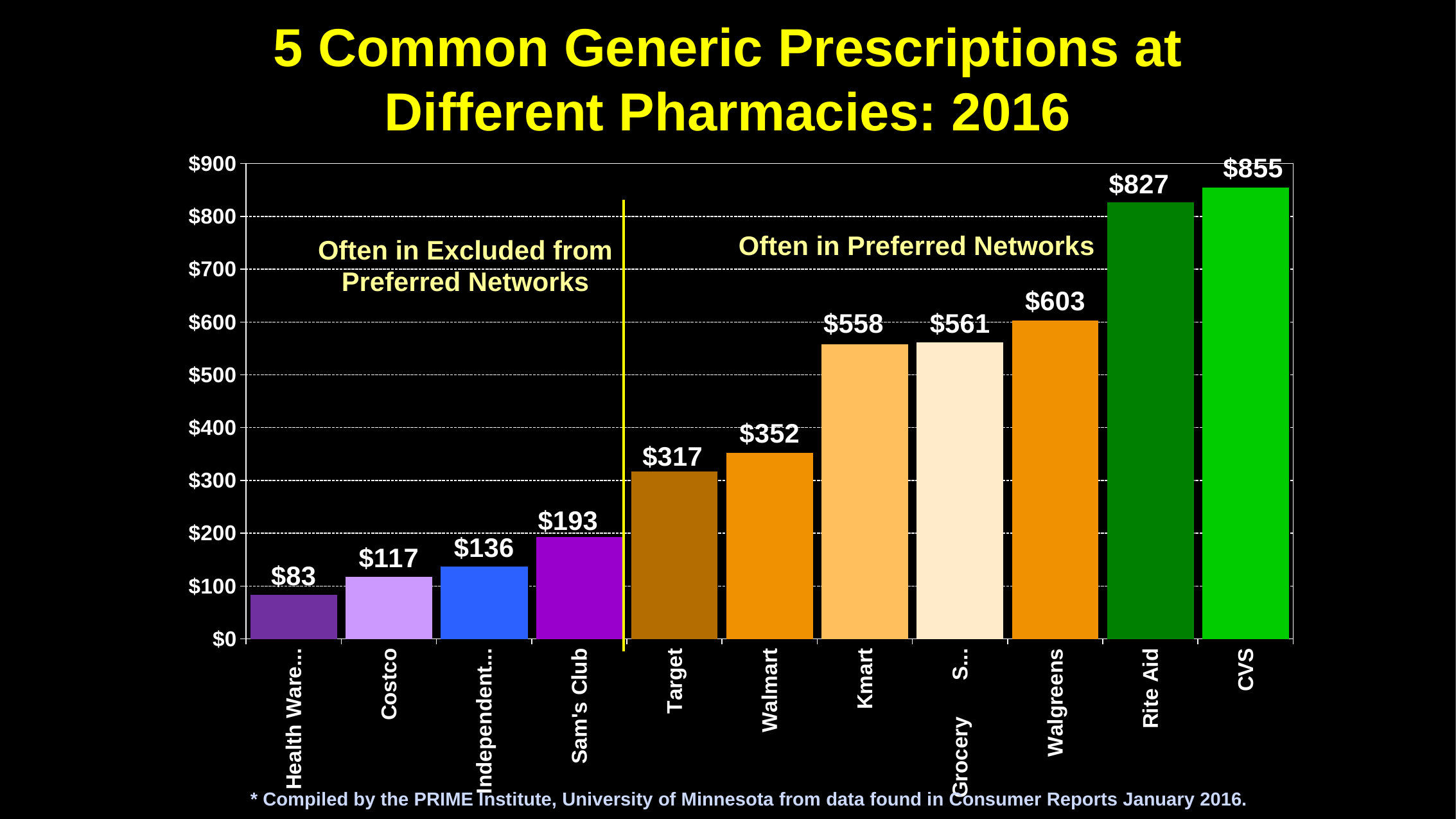
What is the difference between the values for Walmart and Target? $35 What is the value for Walgreens? $603 Which pharmacy has the lowest value? Health Ware... Which pharmacy has the highest value? CVS How many pharmacies are shown on the chart? 11 Which is larger, the value for Walgreens or the value for Kmart? Walgreens What kind of chart is shown on the slide? Bar chart Do the values rise or fall from left to right across the pharmacies? Rise What is the value for Sam's Club? $193 What is the value for CVS? $855 What is the difference between the values for CVS and Rite Aid? $28 What is the value for Costco? $117